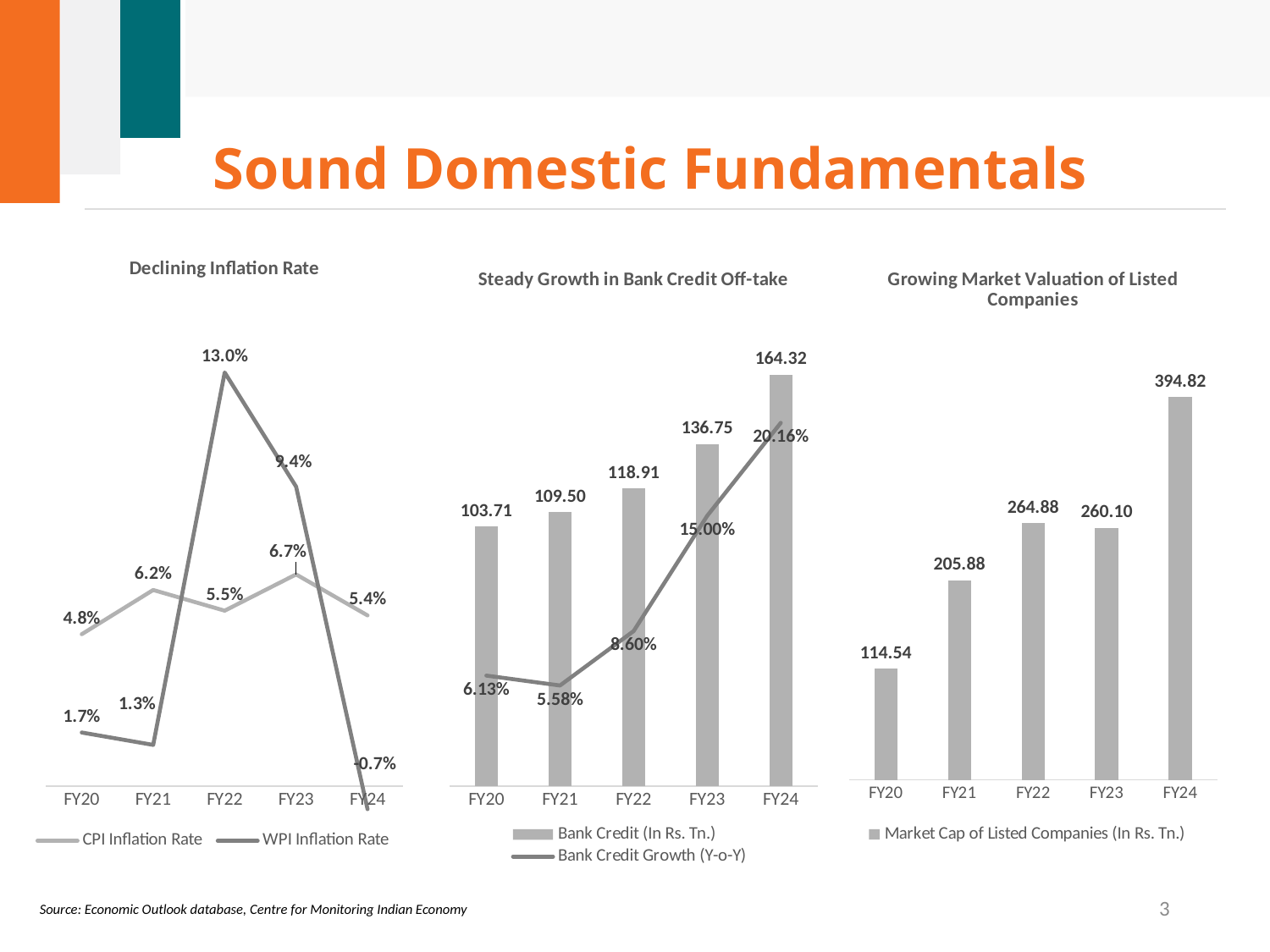
In the 'Declining Inflation Rate' chart, how many series does the legend list? 2 In the 'Steady Growth in Bank Credit Off-take' chart, what is the Bank Credit Growth (Y-o-Y) for FY24? 20.16% In the 'Declining Inflation Rate' chart, which is larger in FY23: the CPI Inflation Rate or the WPI Inflation Rate? WPI Inflation Rate In the 'Steady Growth in Bank Credit Off-take' chart, what is the Bank Credit (In Rs. Tn.) for FY23? 136.75 In the 'Declining Inflation Rate' chart, what is the CPI Inflation Rate for FY24? 5.4% In the 'Declining Inflation Rate' chart, what is the WPI Inflation Rate for FY22? 13.0% In the 'Steady Growth in Bank Credit Off-take' chart, what is the difference in Bank Credit (In Rs. Tn.) between FY24 and FY20? 60.61 In the 'Growing Market Valuation of Listed Companies' chart, which fiscal year has the highest market cap? FY24 In the 'Steady Growth in Bank Credit Off-take' chart, does Bank Credit (In Rs. Tn.) rise or fall from FY20 to FY24? Rise In the 'Declining Inflation Rate' chart, which fiscal year has the lowest WPI Inflation Rate? FY24 In the 'Growing Market Valuation of Listed Companies' chart, what is the Market Cap of Listed Companies (In Rs. Tn.) for FY21? 205.88 In the 'Growing Market Valuation of Listed Companies' chart, how many fiscal years are shown on the x axis? 5